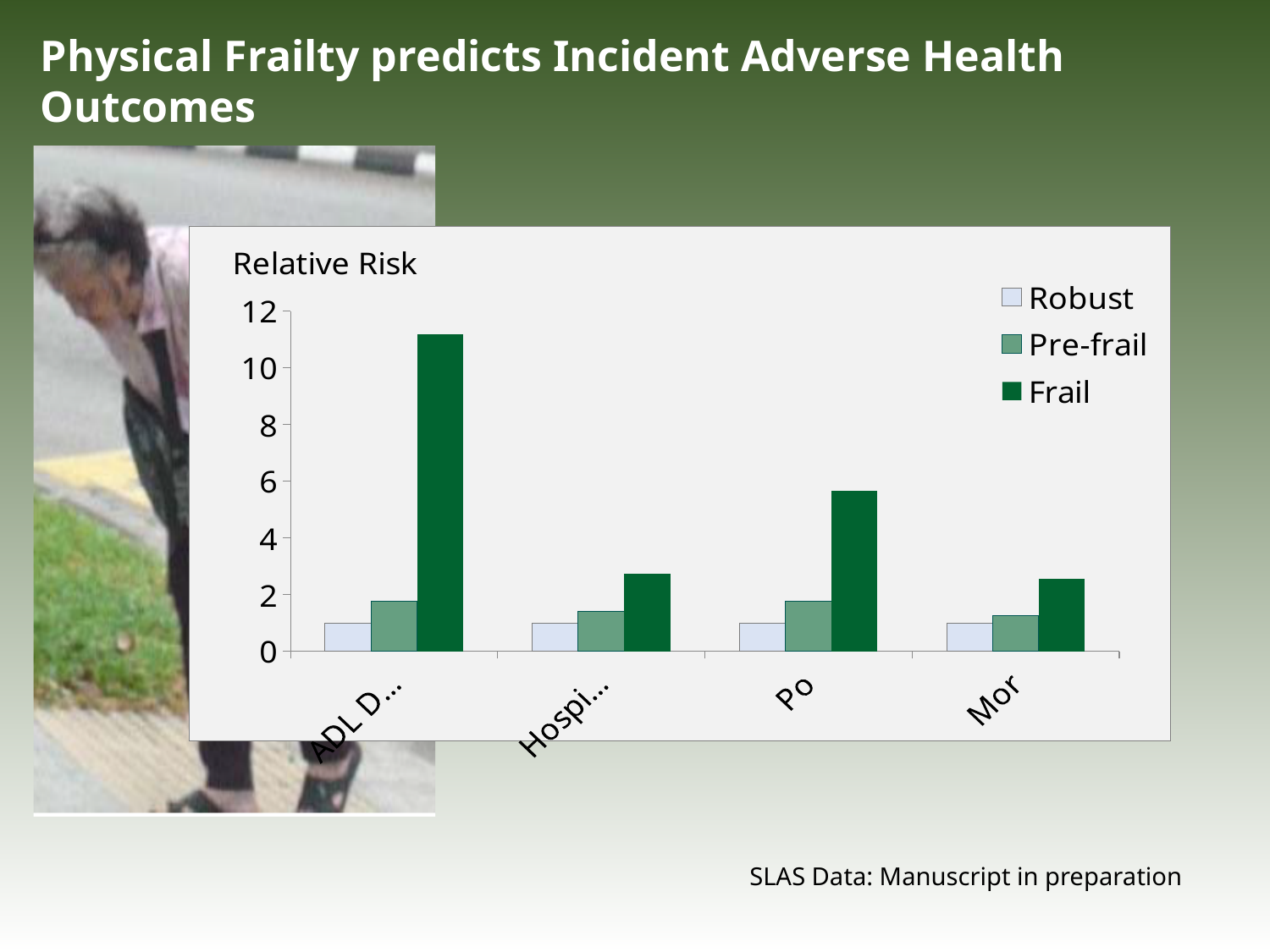
Which series is drawn in the darkest green in the chart? Frail Which series has the tallest bar in the chart? Frail What kind of chart is shown on the slide? bar chart How many category groups are plotted along the x axis of the chart? 4 In the fourth category group, which series has the smaller value, Robust or Frail? Robust In which category group (by position from the left) does the Frail series reach its highest value? the first group In the second category group, which series has the larger value, Pre-frail or Frail? Frail Is the Pre-frail value in the first category group greater or less than 2? less What is the title of the chart? Relative Risk How many series does the chart's legend list? 3 Is the Frail value in the first category group greater or less than 10? greater Is the Frail value in the third category group greater or less than 4? greater